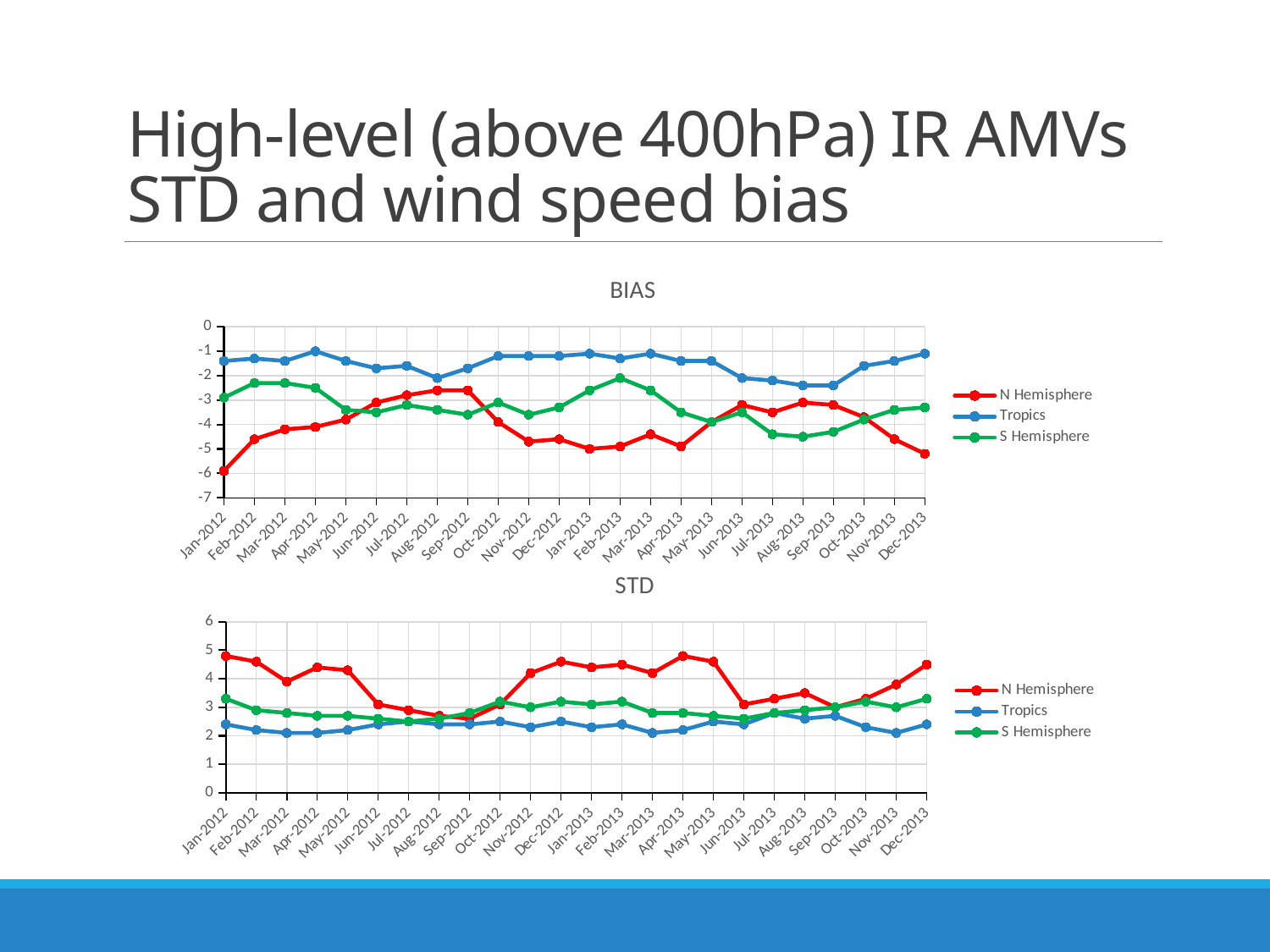
In the STD chart, which is larger in Jun-2013, N Hemisphere or Tropics? N Hemisphere In the BIAS chart, is the S Hemisphere value for Feb-2013 greater or less than -3? greater In the STD chart, is the Tropics value for Mar-2012 greater or less than 3? less What kind of chart is the BIAS chart? line chart In the STD chart, does the N Hemisphere series rise or fall from May-2012 to Aug-2012? fall In the BIAS chart, in which month does the N Hemisphere series reach its lowest value? Jan-2012 In the STD chart, is the N Hemisphere value for Jan-2012 greater or less than 4? greater How many months are plotted along the x axis of the BIAS chart? 24 In the BIAS chart, which series has the highest value in Jan-2012? Tropics How many series does the legend of the STD chart list? 3